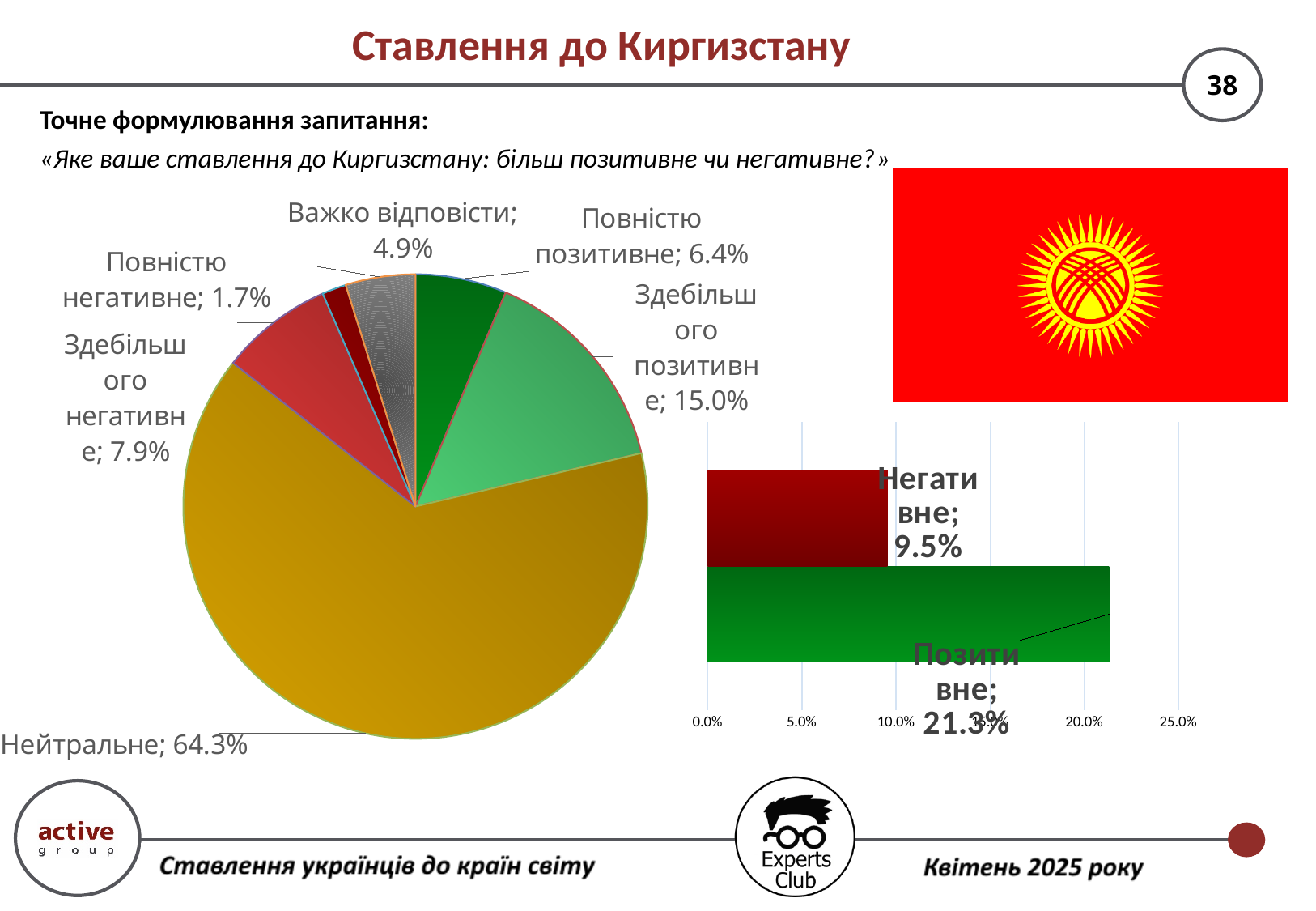
In the bar chart on the right, what is the value for "Позитивне"? 21.3% What type of chart is shown on the right side of the slide? Bar chart In the pie chart on the left, which category has the largest slice? Нейтральне In the pie chart on the left, what is the difference between "Здебільшого позитивне" and "Здебільшого негативне"? 7.1% In the bar chart on the right, what is the value for "Негативне"? 9.5% In the pie chart on the left, what share is labelled for "Нейтральне"? 64.3% In the pie chart on the left, which category has the smallest slice? Повністю негативне In the pie chart on the left, how many slices are there? 6 In the pie chart on the left, what share is labelled for "Повністю негативне"? 1.7% In the pie chart on the left, which is larger: "Повністю позитивне" or "Важко відповісти"? Повністю позитивне In the pie chart on the left, what share is labelled for "Здебільшого позитивне"? 15.0% In the bar chart on the right, what is the difference between "Позитивне" and "Негативне"? 11.8%